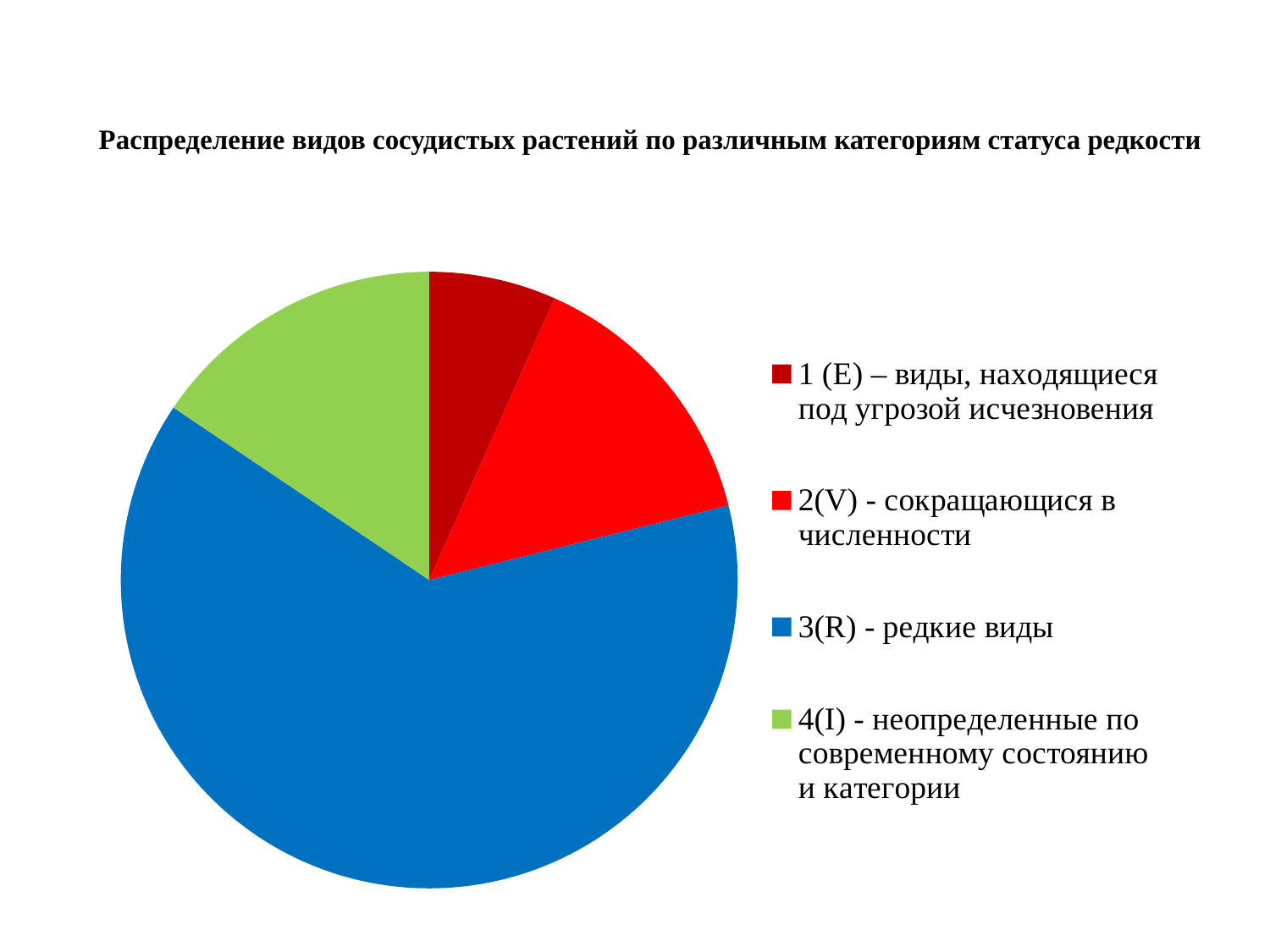
What colour is the slice for 3(R) - редкие виды? blue Which slice is larger: 1 (E) – виды, находящиеся под угрозой исчезновения or 4(I) - неопределенные по современному состоянию и категории? 4(I) - неопределенные по современному состоянию и категории What kind of chart is shown on the slide? pie chart Which slice is larger: 3(R) - редкие виды or 2(V) - сокращающиеся в численности? 3(R) - редкие виды Which category has the largest slice of the pie? 3(R) - редкие виды Does the slice for 3(R) - редкие виды make up more or less than half of the pie? more Which category has the smallest slice of the pie? 1 (E) – виды, находящиеся под угрозой исчезновения Which slice is larger: 3(R) - редкие виды or 4(I) - неопределенные по современному состоянию и категории? 3(R) - редкие виды How many categories (slices) does the pie chart have? 4 What is the title of the chart? Распределение видов сосудистых растений по различным категориям статуса редкости